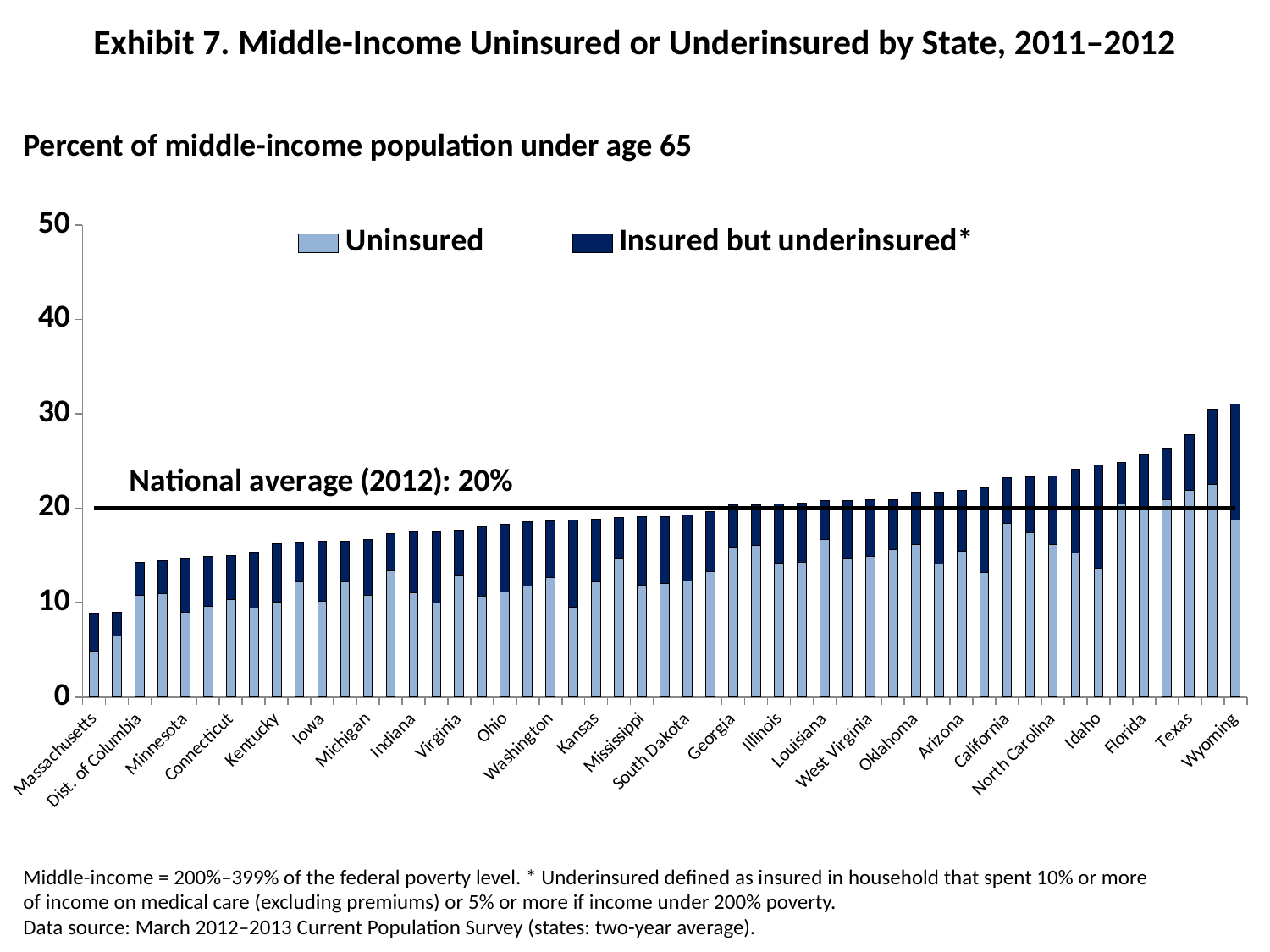
How many series does the legend list? 2 What kind of chart is shown on the slide? Stacked bar chart Is the total value for Massachusetts greater or less than 10? less Which has a larger total value, Texas or Ohio? Texas Is the total value for Minnesota greater or less than 20? less Which state has the highest total percent of middle-income uninsured or underinsured? Wyoming Do the total bar heights rise or fall moving from left to right across the states? Rise Which state has the lowest total percent of middle-income uninsured or underinsured? Massachusetts What national average value is marked by the horizontal line on the chart? 20% Is the total value for Wyoming greater or less than 30? greater What are the two series named in the legend? Uninsured; Insured but underinsured*